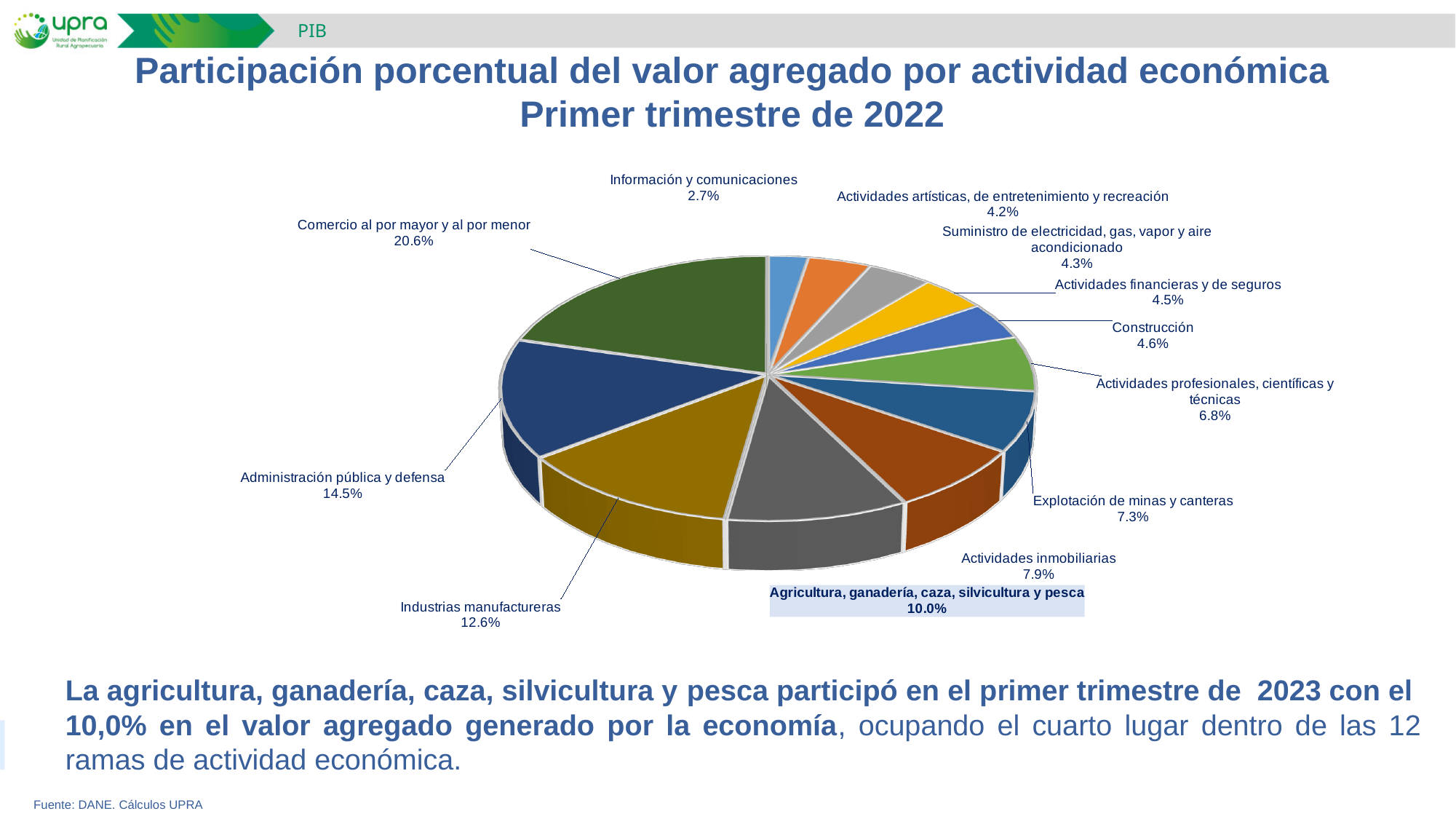
What is the combined share of Información y comunicaciones and Actividades artísticas, de entretenimiento y recreación? 6.9% What is the share for Agricultura, ganadería, caza, silvicultura y pesca? 10.0% What is the title of the chart? Participación porcentual del valor agregado por actividad económica Primer trimestre de 2022 Which economic activity has the smallest share of the pie? Información y comunicaciones What is the share for Construcción? 4.6% Which has a larger share, Actividades inmobiliarias or Actividades profesionales, científicas y técnicas? Actividades inmobiliarias Which economic activity has the largest share of the pie? Comercio al por mayor y al por menor How many economic activities (slices) are shown in the pie chart? 12 What is the share for Comercio al por mayor y al por menor? 20.6% What is the difference in percentage points between Administración pública y defensa and Industrias manufactureras? 1.9 What kind of chart is shown on the slide? Pie chart What is the share for Explotación de minas y canteras? 7.3%